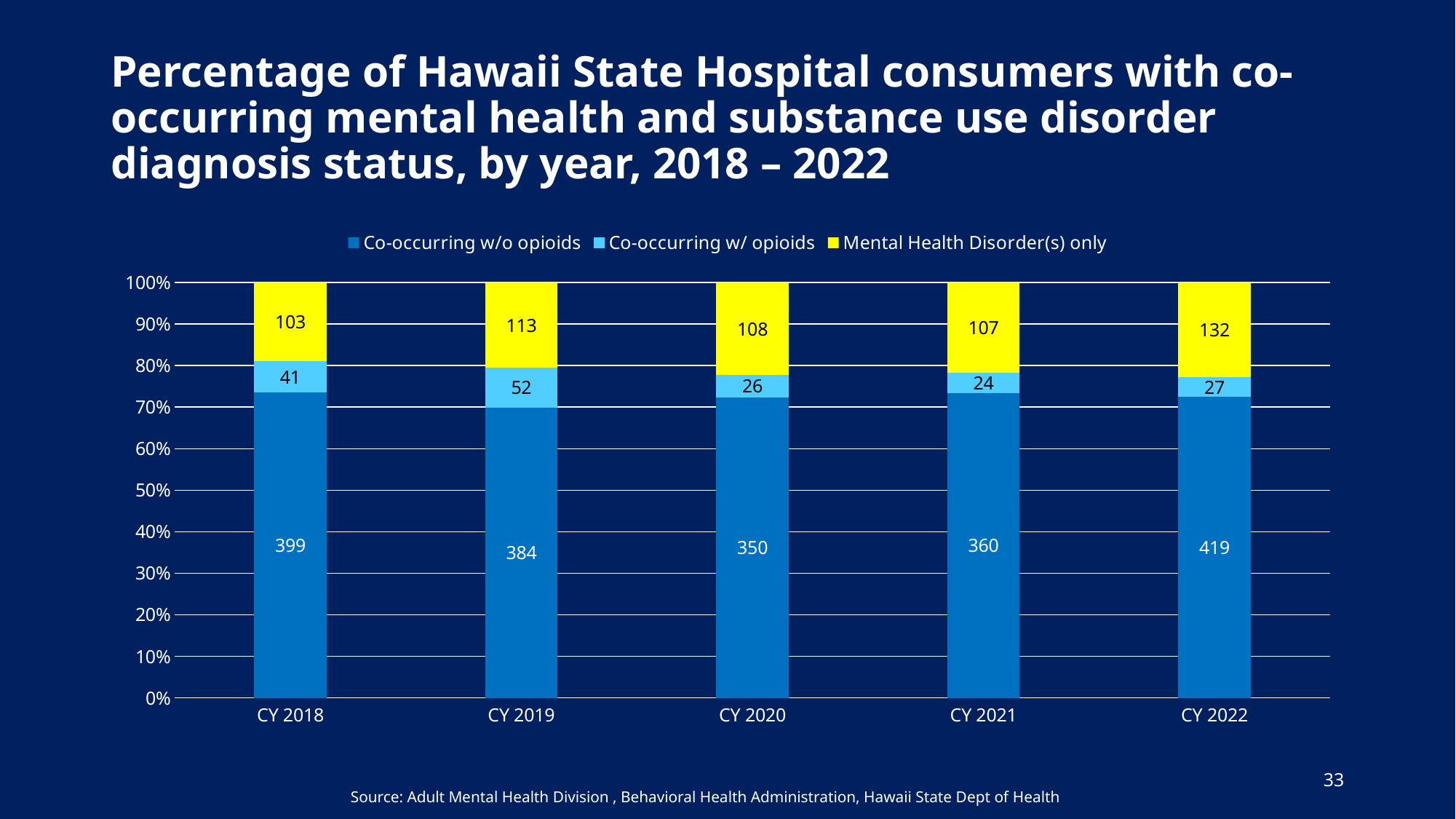
Which year has the highest data label for Co-occurring w/ opioids? CY 2019 What is the difference between the Mental Health Disorder(s) only labels for CY 2022 and CY 2018? 29 What is the data label for Mental Health Disorder(s) only in CY 2020? 108 What is the data label for Co-occurring w/o opioids in CY 2022? 419 How many series does the legend list? 3 What is the data label for Co-occurring w/ opioids in CY 2019? 52 What is the sum of the three data labels in the CY 2018 bar? 543 How many years are shown on the x axis? 5 Which series is shown in yellow? Mental Health Disorder(s) only Which year has the lowest data label for Co-occurring w/o opioids? CY 2020 What kind of chart is shown on the slide? Stacked bar chart Which is larger, the Co-occurring w/ opioids label for CY 2021 or for CY 2022? CY 2022